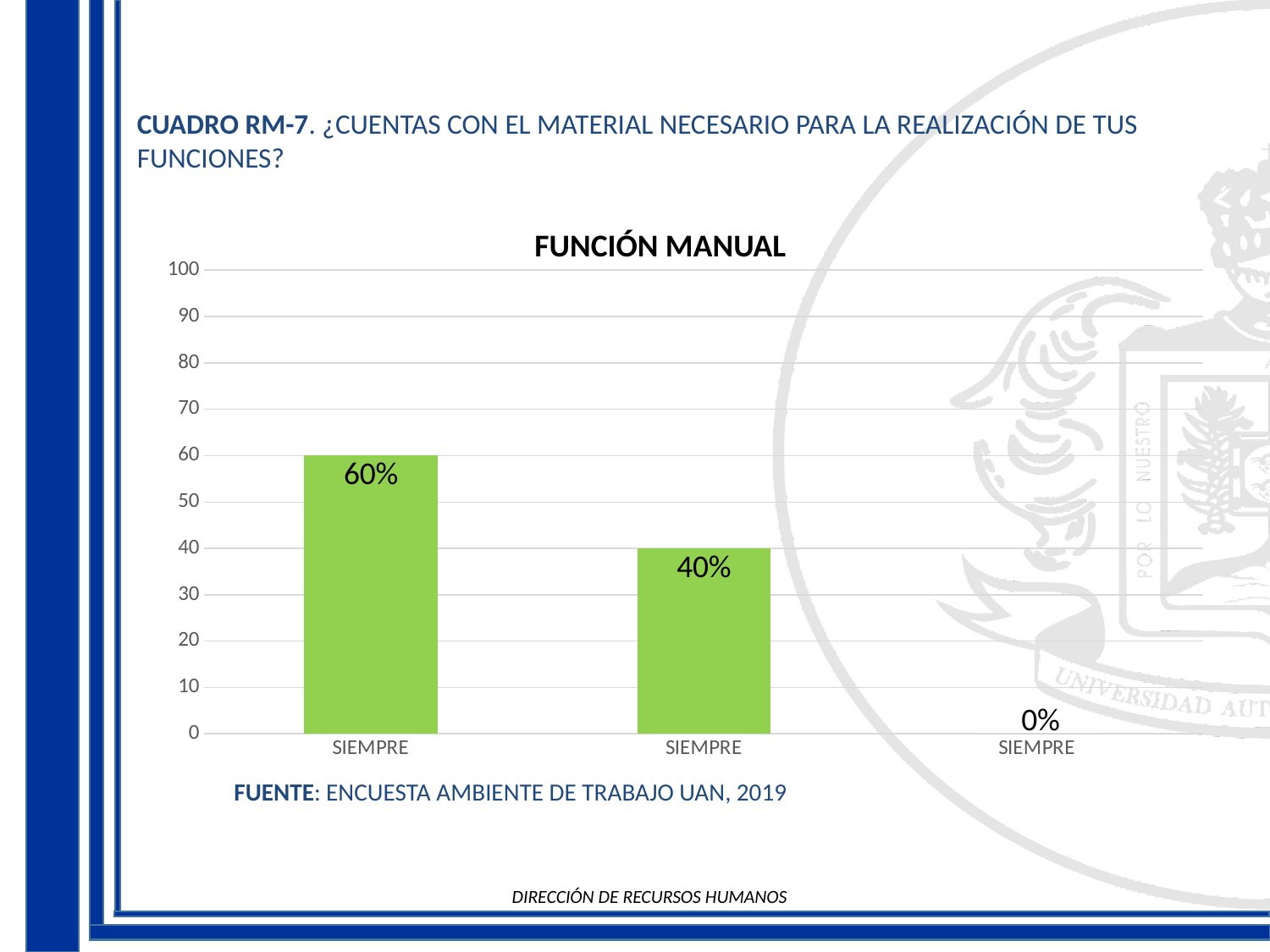
What is the title of the chart? FUNCIÓN MANUAL What is the value shown on the leftmost bar of the chart? 60% What category label appears under each of the three bars? SIEMPRE What kind of chart is shown on the slide? bar chart How many bars (categories) does the chart show? 3 Which is larger, the value of the middle bar or the value of the right bar? middle bar What is the value shown on the middle bar of the chart? 40% Which bar has the highest value, the left, middle or right one? left Do the bar values rise or fall from left to right along the x axis? fall What is the value shown on the rightmost bar of the chart? 0% What is the difference between the values of the left bar and the middle bar? 20% Which bar has the lowest value, the left, middle or right one? right